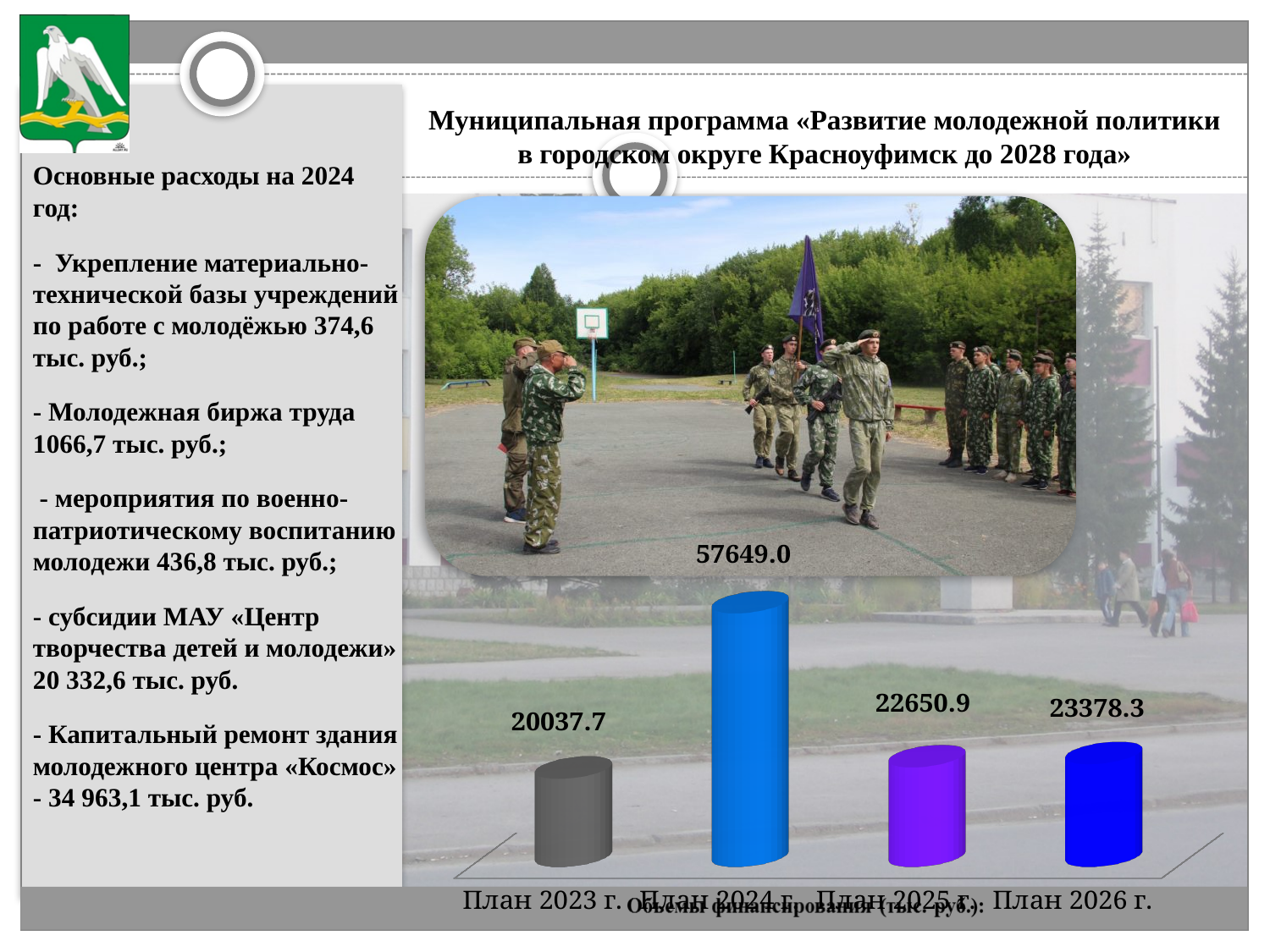
Which is larger, the value for План 2025 г. or the value for План 2023 г.? План 2025 г. What is the value for План 2024 г. in the bar chart? 57649.0 What is the value for План 2025 г. in the bar chart? 22650.9 How many categories are shown in the bar chart? 4 What is the value for План 2026 г. in the bar chart? 23378.3 What colour is the bar for План 2024 г.? Blue What is the difference between the values for План 2026 г. and План 2025 г.? 727.4 Which category has the lowest value in the bar chart? План 2023 г. What is the difference between the values for План 2024 г. and План 2023 г.? 37611.3 Which category has the highest value in the bar chart? План 2024 г. What is the value for План 2023 г. in the bar chart? 20037.7 What kind of chart is shown on the slide? Bar chart